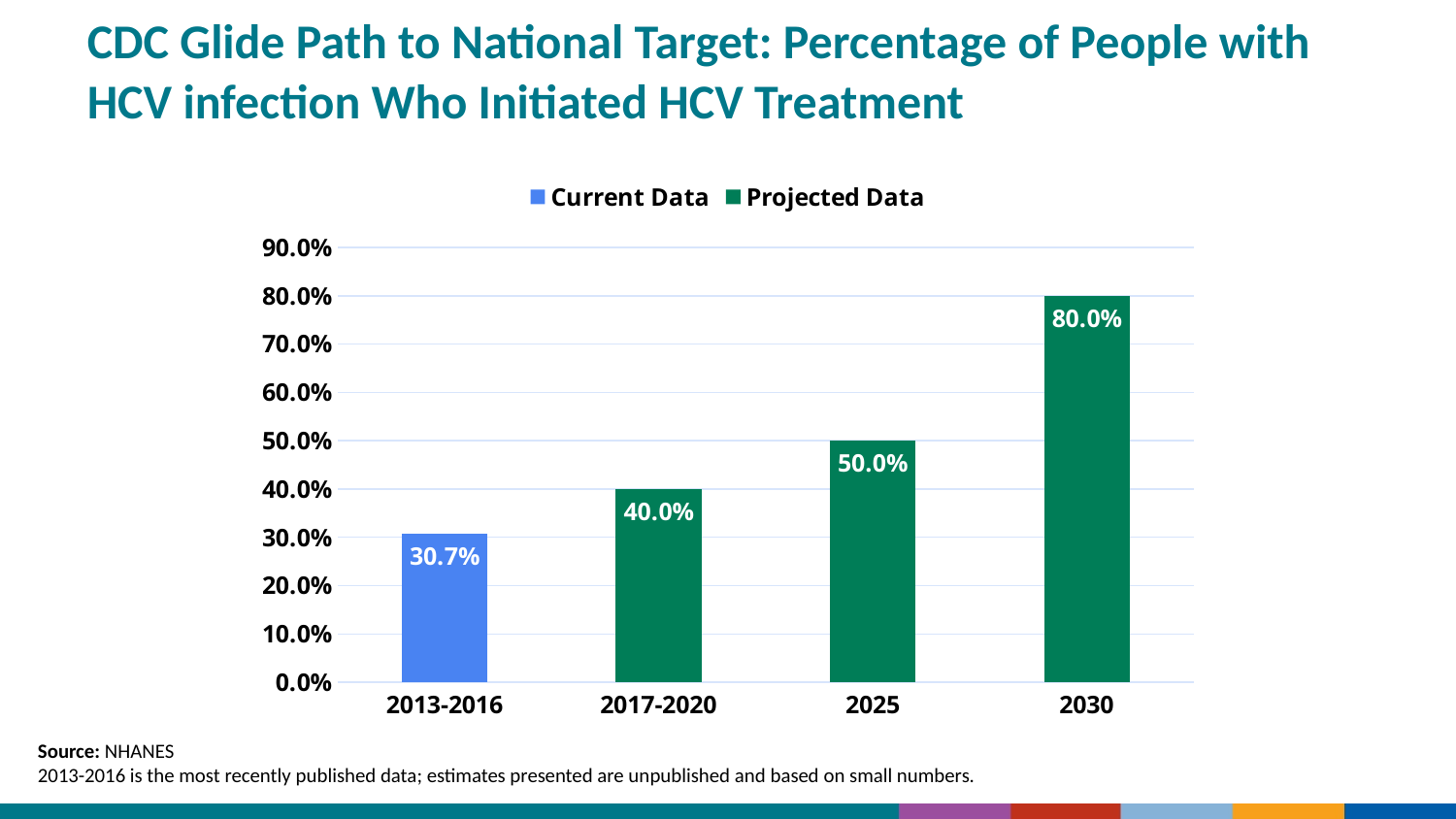
What is the value for 2030? 80.0% What is the difference between the values for 2017-2020 and 2013-2016? 9.3% How many categories are shown on the x axis? 4 What is the value for 2025? 50.0% What is the value for 2013-2016? 30.7% How many series does the legend list? 2 What kind of chart is shown on the slide? Bar chart Which category has the lowest value? 2013-2016 Which is larger, the value for 2025 or the value for 2017-2020? 2025 What is the difference between the values for 2030 and 2025? 30.0% What is the value for 2017-2020? 40.0% Which category has the highest value? 2030